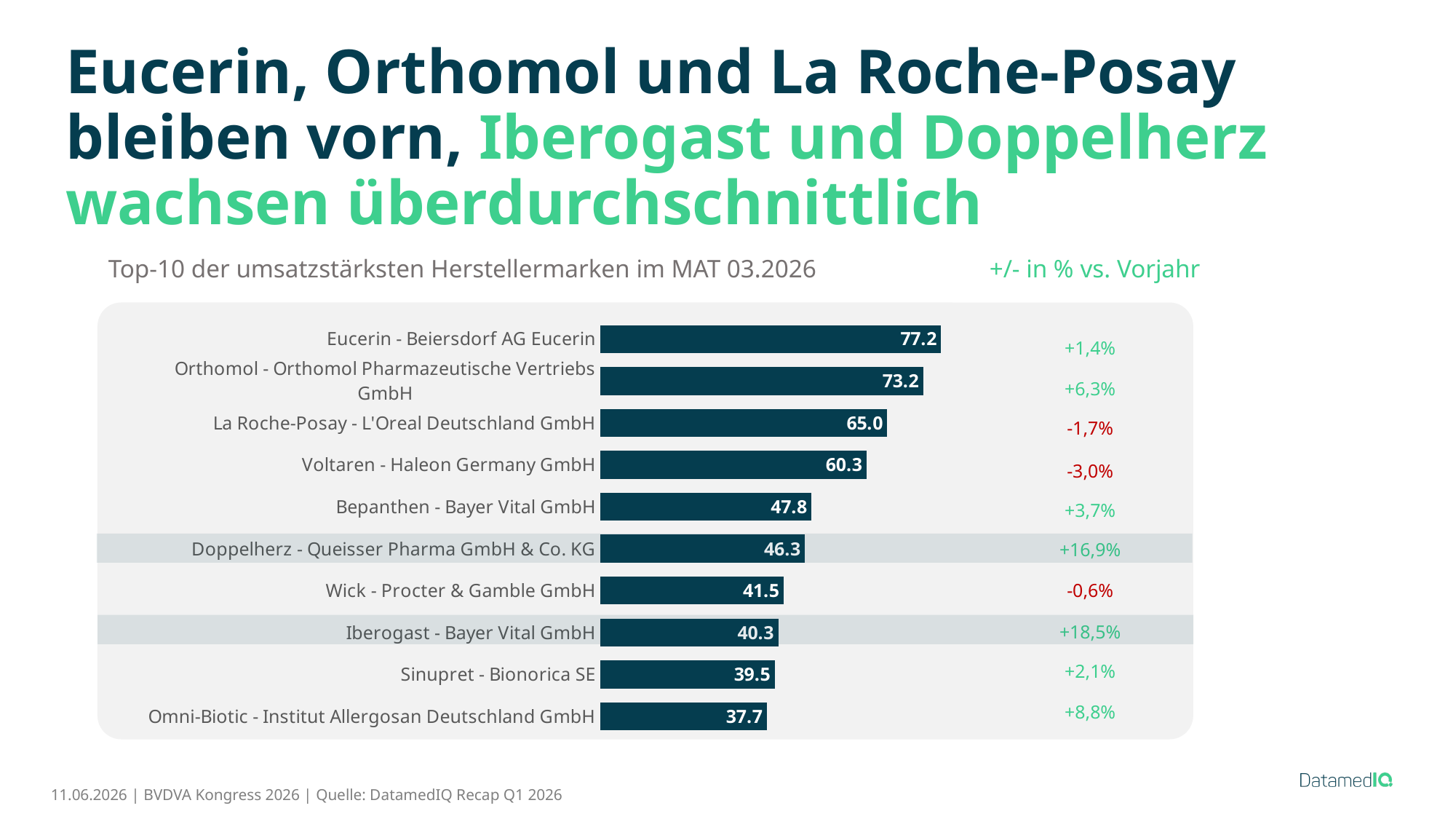
Do the bar values rise or fall from the top of the chart to the bottom? Fall What is the value shown for Doppelherz - Queisser Pharma GmbH & Co. KG? 46.3 What is the year-over-year change shown for Voltaren - Haleon Germany GmbH? -3,0% Which brand has the highest value in the chart? Eucerin - Beiersdorf AG Eucerin Which has a larger value, Voltaren - Haleon Germany GmbH or Bepanthen - Bayer Vital GmbH? Voltaren - Haleon Germany GmbH What is the difference between the values for Eucerin - Beiersdorf AG Eucerin and Orthomol - Orthomol Pharmazeutische Vertriebs GmbH? 4.0 What is the year-over-year change (+/- in % vs. Vorjahr) shown for Iberogast - Bayer Vital GmbH? +18,5% What kind of chart is shown on the slide? Bar chart What is the value shown for Eucerin - Beiersdorf AG Eucerin? 77.2 How many brands are shown in the chart? 10 Which brand has the lowest value in the chart? Omni-Biotic - Institut Allergosan Deutschland GmbH What is the subtitle of the chart? Top-10 der umsatzstärksten Herstellermarken im MAT 03.2026